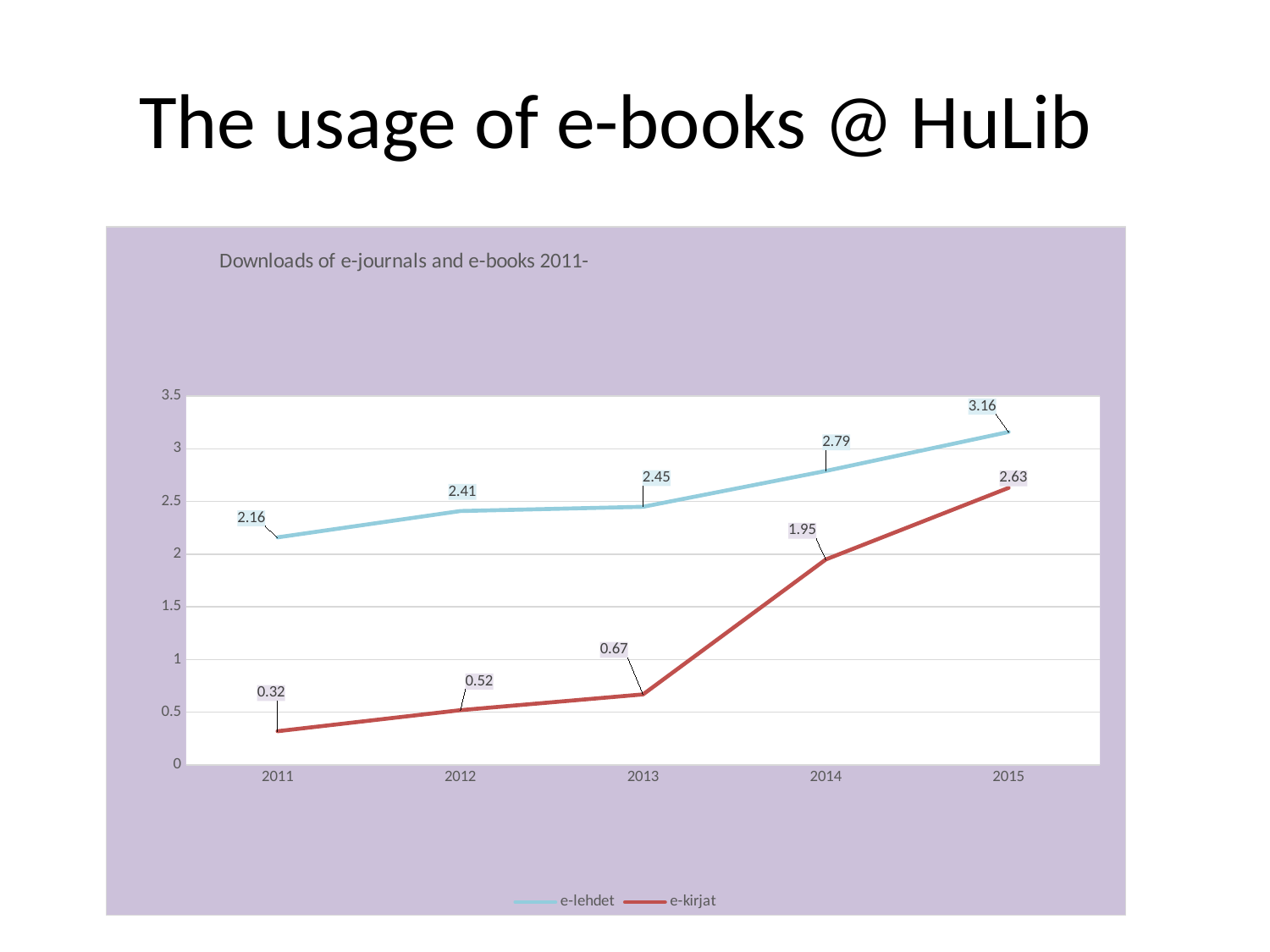
What is the value for e-kirjat in 2011? 0.32 What is the difference between the e-lehdet and e-kirjat values in 2015? 0.53 Do the e-kirjat values rise or fall from 2011 to 2015? rise How many years are shown on the x axis? 5 What kind of chart is shown on the slide? line chart How many series does the legend list? 2 What is the value for e-kirjat in 2014? 1.95 In which year is the e-lehdet value highest? 2015 What is the title of the chart? Downloads of e-journals and e-books 2011- What is the value for e-lehdet in 2013? 2.45 In which year is the e-kirjat value lowest? 2011 Which series has the larger value in 2014, e-lehdet or e-kirjat? e-lehdet